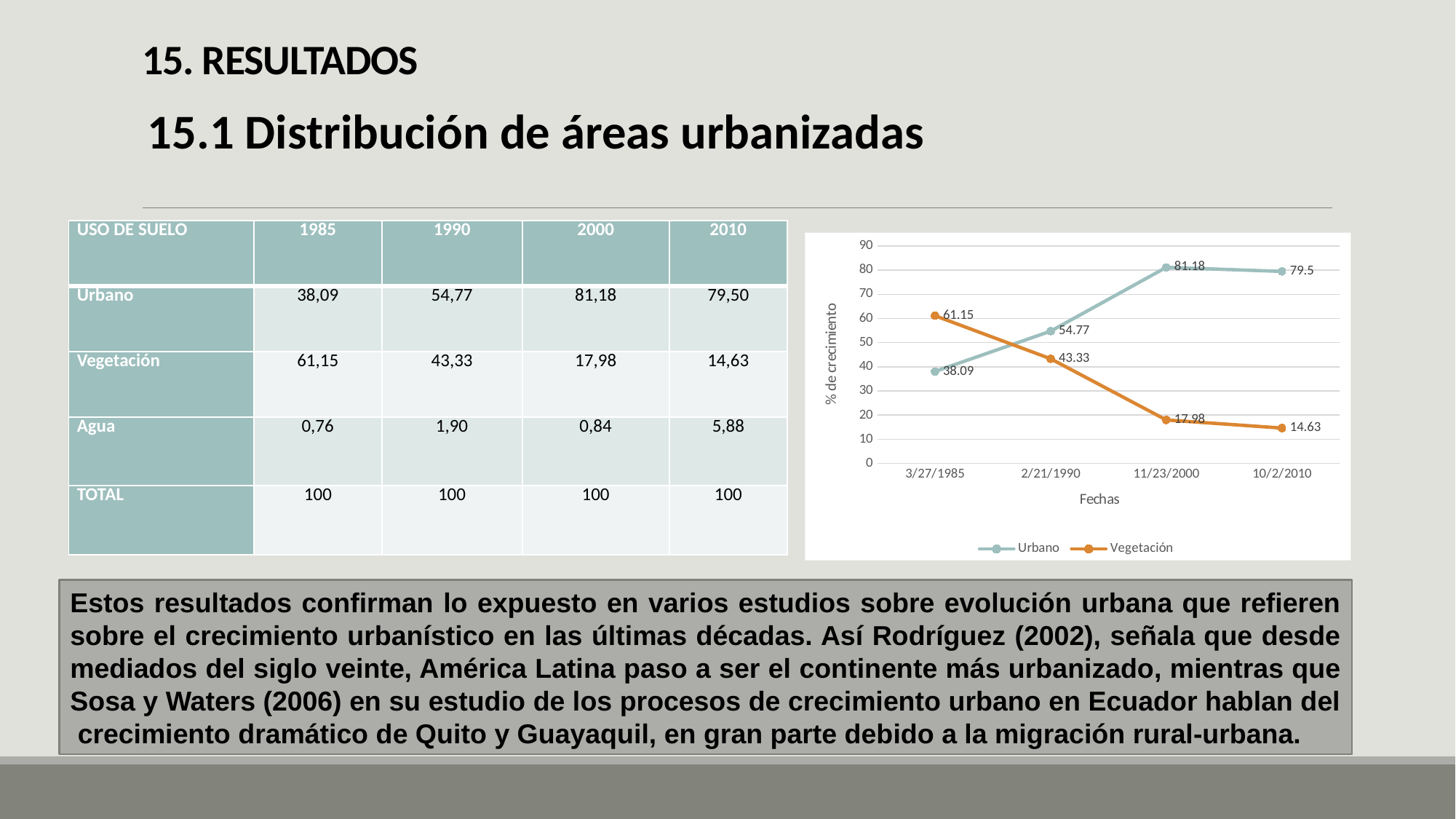
At 3/27/1985, which series has the larger value, Urbano or Vegetación? Vegetación How many dates are plotted on the x axis of the chart? 4 At which date does the Urbano series reach its highest value? 11/23/2000 At which date is the Vegetación series lowest? 10/2/2010 How many series does the chart legend list? 2 What is the value of the Urbano series at 3/27/1985? 38.09 What is the value of the Urbano series at 10/2/2010? 79.5 What is the difference between the Urbano and Vegetación values at 2/21/1990? 11.44 What is the value of the Vegetación series at 11/23/2000? 17.98 What is the title of the chart's y axis? % de crecimiento Does the Vegetación series rise or fall from 3/27/1985 to 10/2/2010? fall What kind of chart is shown on the slide? line chart